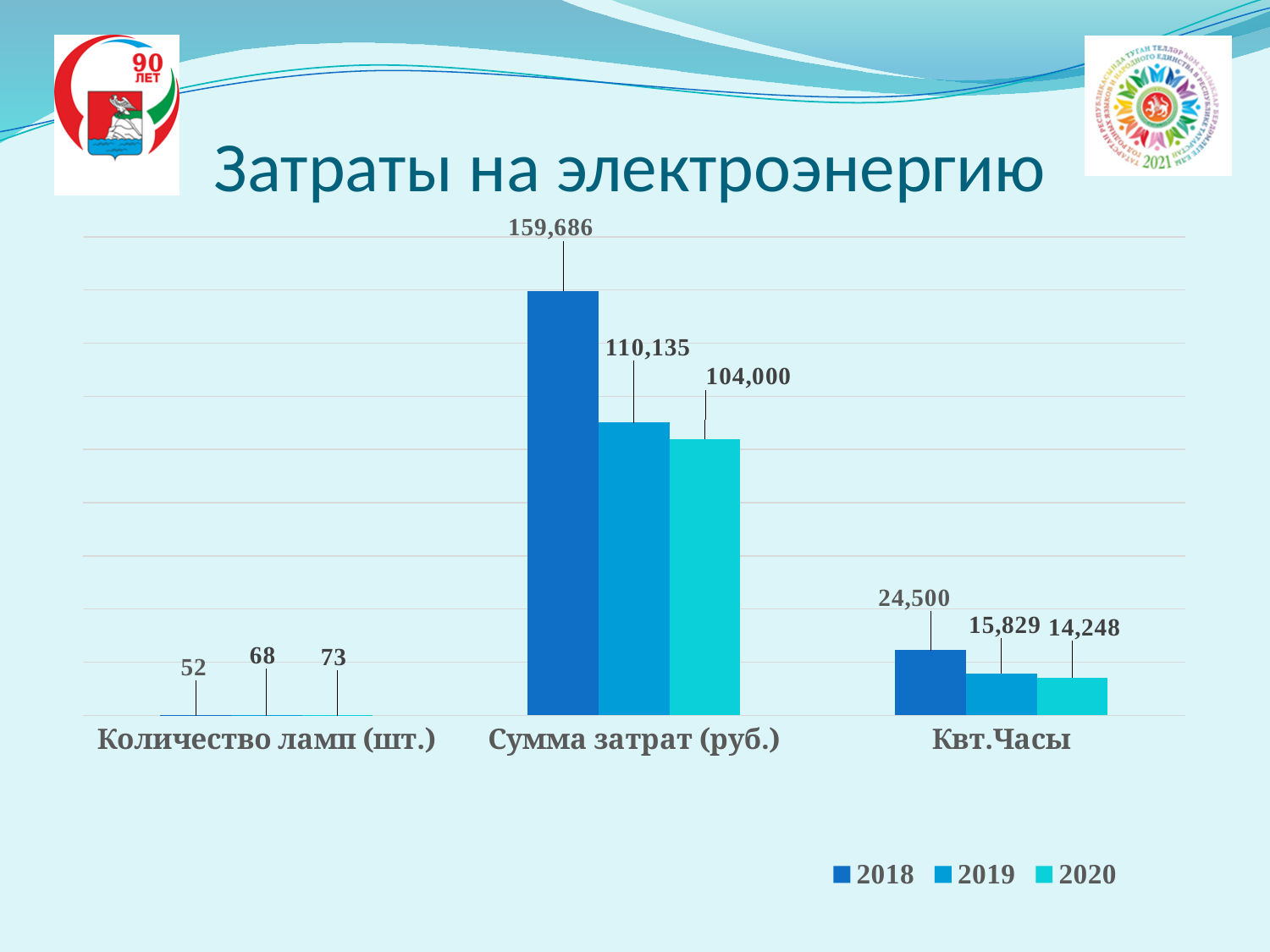
What is the value for 2018 in the Сумма затрат (руб.) category? 159,686 What is the difference between the 2018 and 2019 values in the Квт.Часы category? 8,671 How many series does the legend list? 3 What kind of chart is shown on the slide? Bar chart Which year has the highest value in the Сумма затрат (руб.) category? 2018 What is the difference between the 2018 and 2020 values in the Сумма затрат (руб.) category? 55,686 How many categories are shown on the x axis? 3 Which is larger in the Квт.Часы category: the value for 2019 or the value for 2020? 2019 What is the title of the chart? Затраты на электроэнергию What is the value for 2019 in the Количество ламп (шт.) category? 68 Which year has the lowest value in the Количество ламп (шт.) category? 2018 What is the value for 2020 in the Квт.Часы category? 14,248